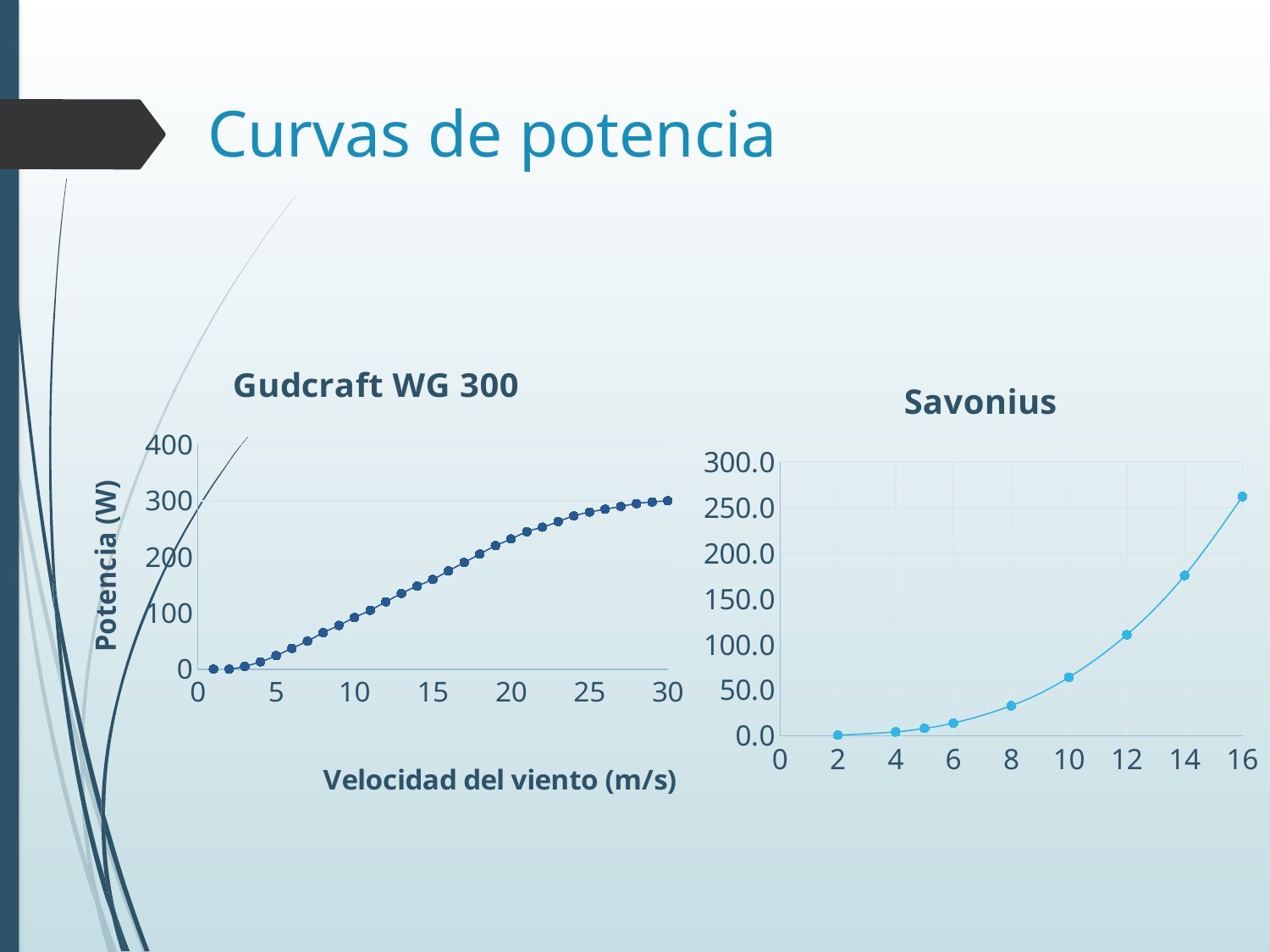
In the Gudcraft WG 300 chart, is the value at 15 m/s greater or less than 100? greater In the Savonius chart, is the value at 16 greater or less than 250.0? greater How many data points are plotted in the Savonius chart? 9 What kind of chart is the Gudcraft WG 300 chart? line chart In the Gudcraft WG 300 chart, is the value at 20 m/s greater or less than 200? greater What is the y-axis title of the Gudcraft WG 300 chart? Potencia (W) In the Savonius chart, do the values rise or fall as the x-axis value increases? rise What kind of chart is the Savonius chart? line chart In the Gudcraft WG 300 chart, do the values rise or fall as wind speed increases along the x axis? rise